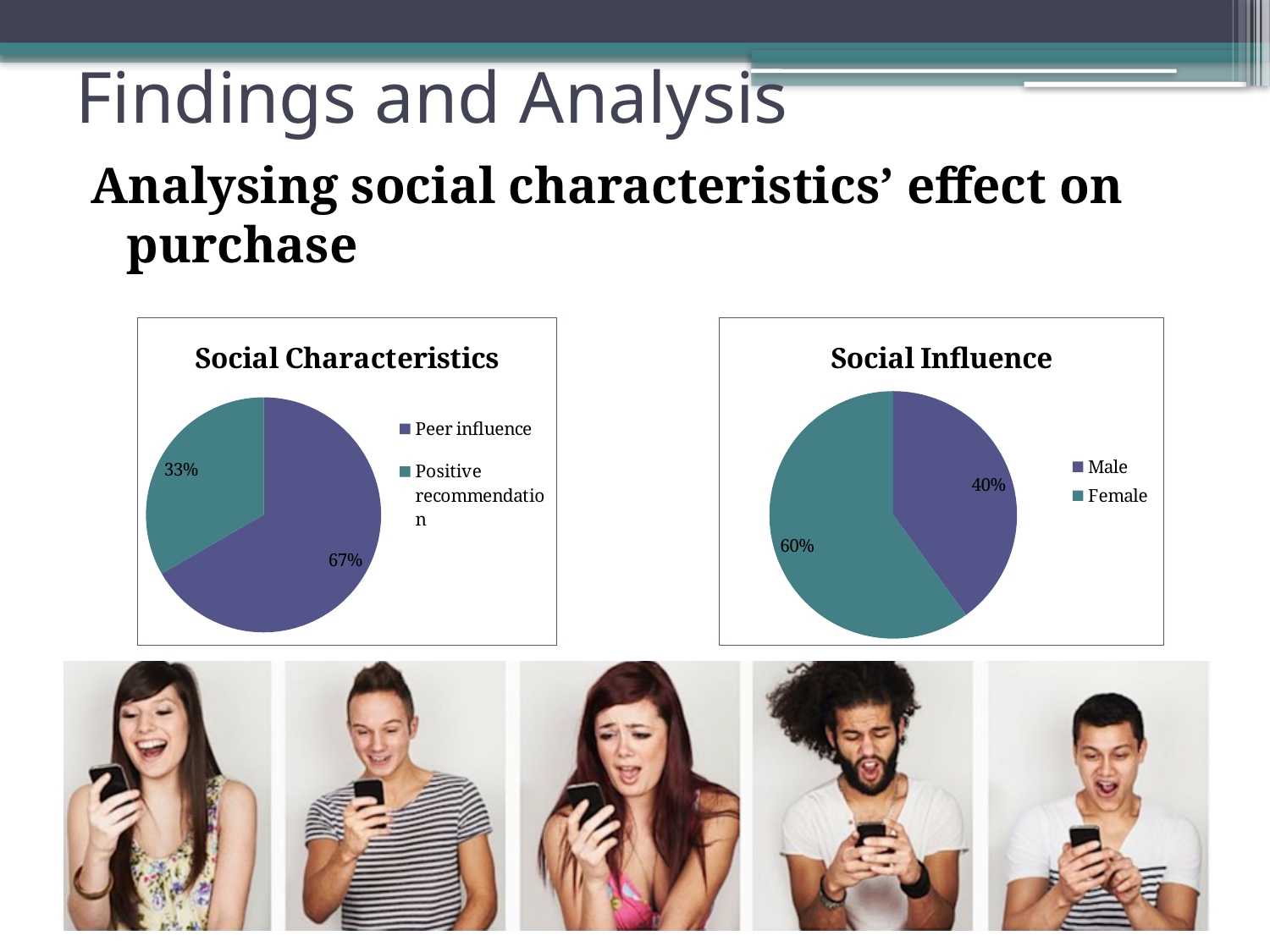
In the Social Characteristics chart, what percentage is shown for Positive recommendation? 33% In the Social Influence chart, what percentage is shown for Female? 60% What type of chart is the Social Characteristics chart? Pie chart In the Social Influence chart, which category has the smallest slice? Male In the Social Influence chart, which is larger, Male or Female? Female In the Social Influence chart, what is the difference between the Female and Male percentages? 20% How many categories does the Social Influence chart's legend list? 2 In the Social Characteristics chart, what percentage is shown for Peer influence? 67% In the Social Characteristics chart, which category has the largest slice? Peer influence What is the title of the chart on the right side of the slide? Social Influence In the Social Characteristics chart, what is the difference between the Peer influence and Positive recommendation percentages? 34% In the Social Influence chart, what percentage is shown for Male? 40%